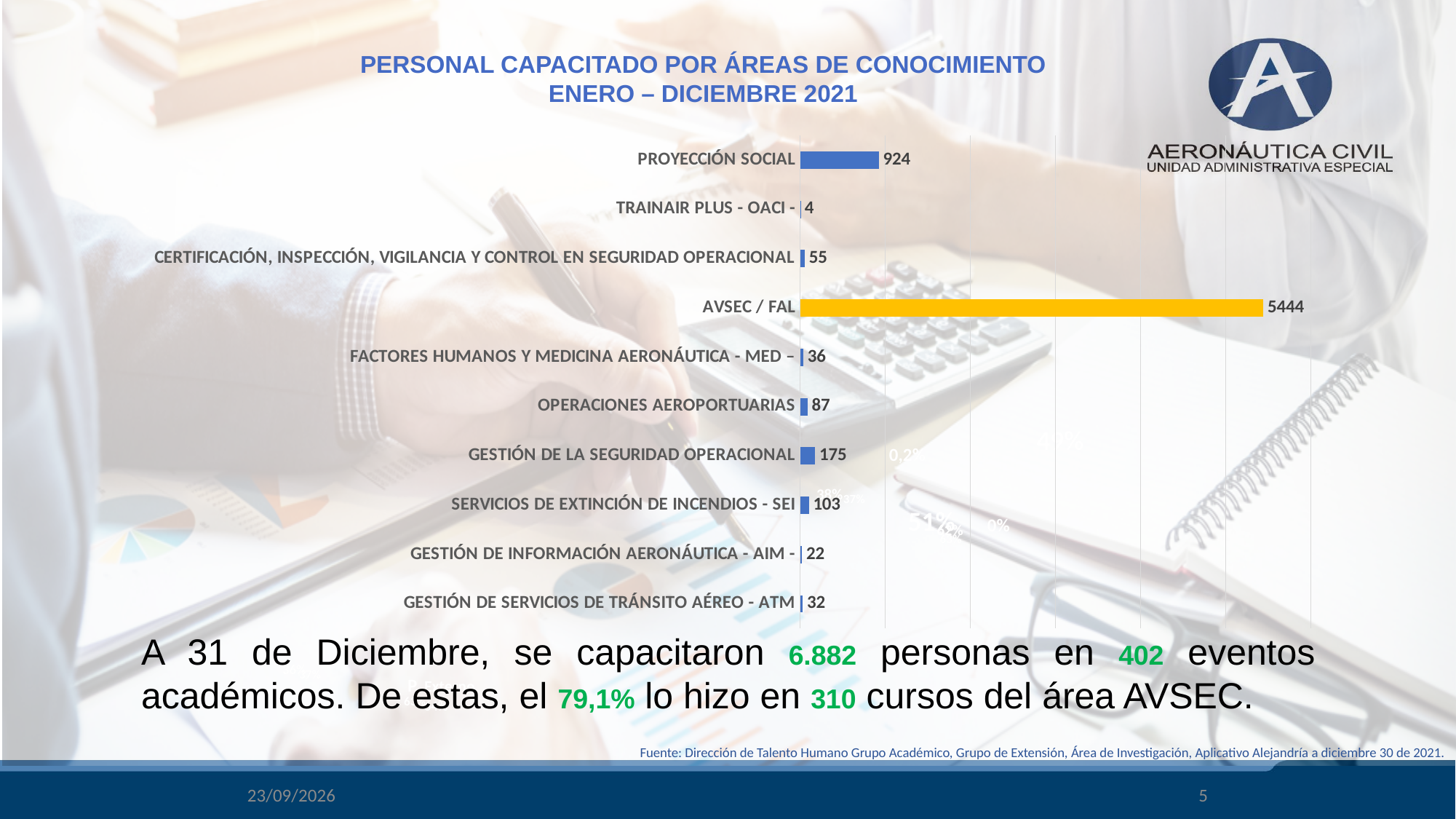
What is the value for GESTIÓN DE LA SEGURIDAD OPERACIONAL? 175 Which is larger, the value for OPERACIONES AEROPORTUARIAS or the value for CERTIFICACIÓN, INSPECCIÓN, VIGILANCIA Y CONTROL EN SEGURIDAD OPERACIONAL? OPERACIONES AEROPORTUARIAS What is the title of the chart? PERSONAL CAPACITADO POR ÁREAS DE CONOCIMIENTO ENERO – DICIEMBRE 2021 Which category has the highest value? AVSEC / FAL What is the difference between the values for AVSEC / FAL and PROYECCIÓN SOCIAL? 4520 What is the value for SERVICIOS DE EXTINCIÓN DE INCENDIOS - SEI? 103 What is the value for PROYECCIÓN SOCIAL? 924 What is the difference between the values for GESTIÓN DE LA SEGURIDAD OPERACIONAL and OPERACIONES AEROPORTUARIAS? 88 What is the value for AVSEC / FAL? 5444 What kind of chart is shown on the slide? Bar chart How many categories are shown in the chart? 10 Which category has the lowest value? TRAINAIR PLUS - OACI